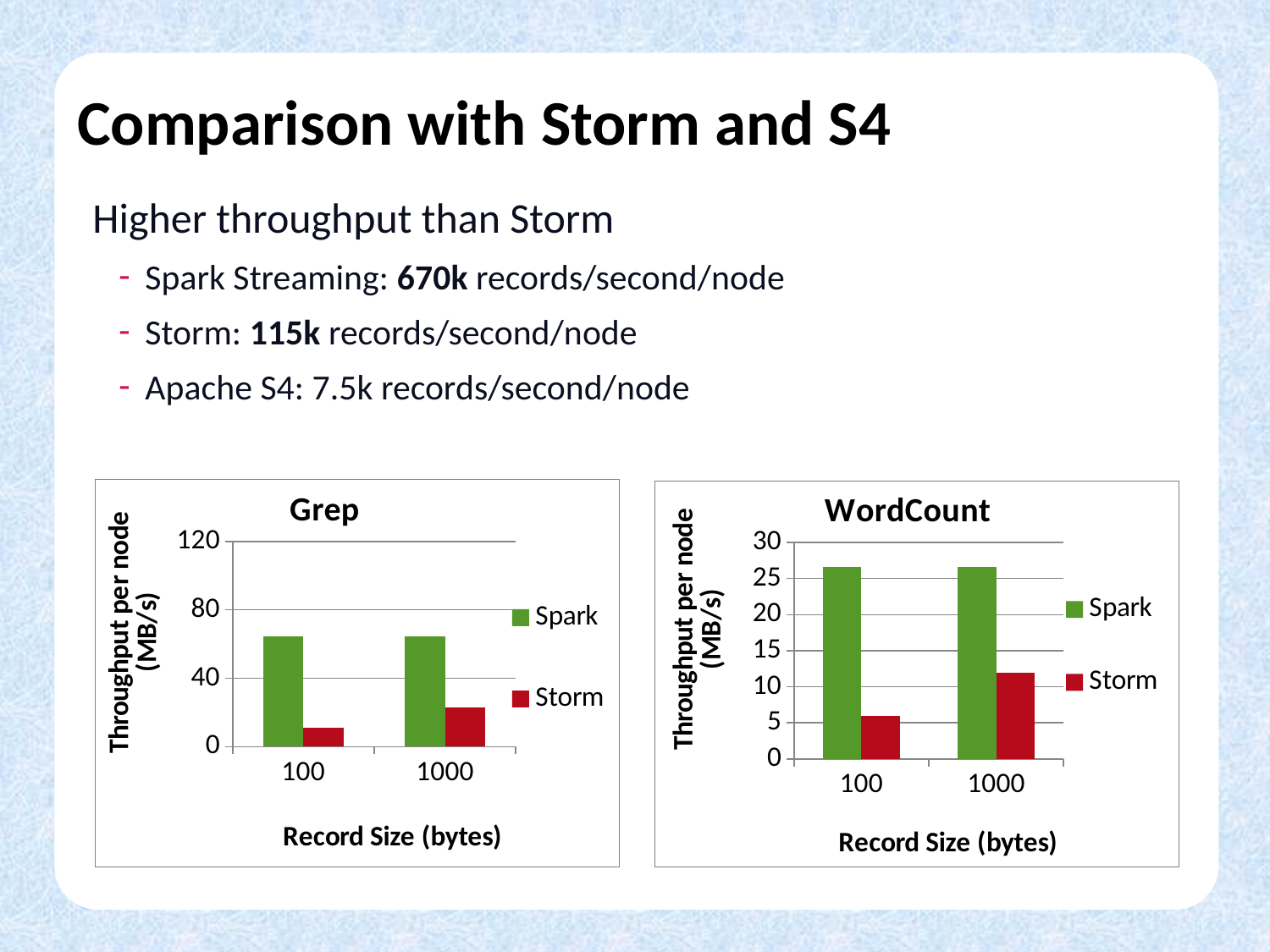
In the Grep chart, is the Spark value for record size 1000 greater or less than 80? less How many series does the legend of the WordCount chart list? 2 How many record-size categories are shown on the x axis of the Grep chart? 2 In the WordCount chart, which record size has the larger Storm value, 100 or 1000? 1000 In the Grep chart, which series has the higher value at record size 100, Spark or Storm? Spark In the WordCount chart, is the Spark value for record size 100 greater or less than 20? greater In the Grep chart, is the Spark value for record size 100 greater or less than 40? greater What kind of chart is the Grep chart? bar chart What is the y-axis label of the WordCount chart? Throughput per node (MB/s) In the Grep chart, which record size has the larger Storm value, 100 or 1000? 1000